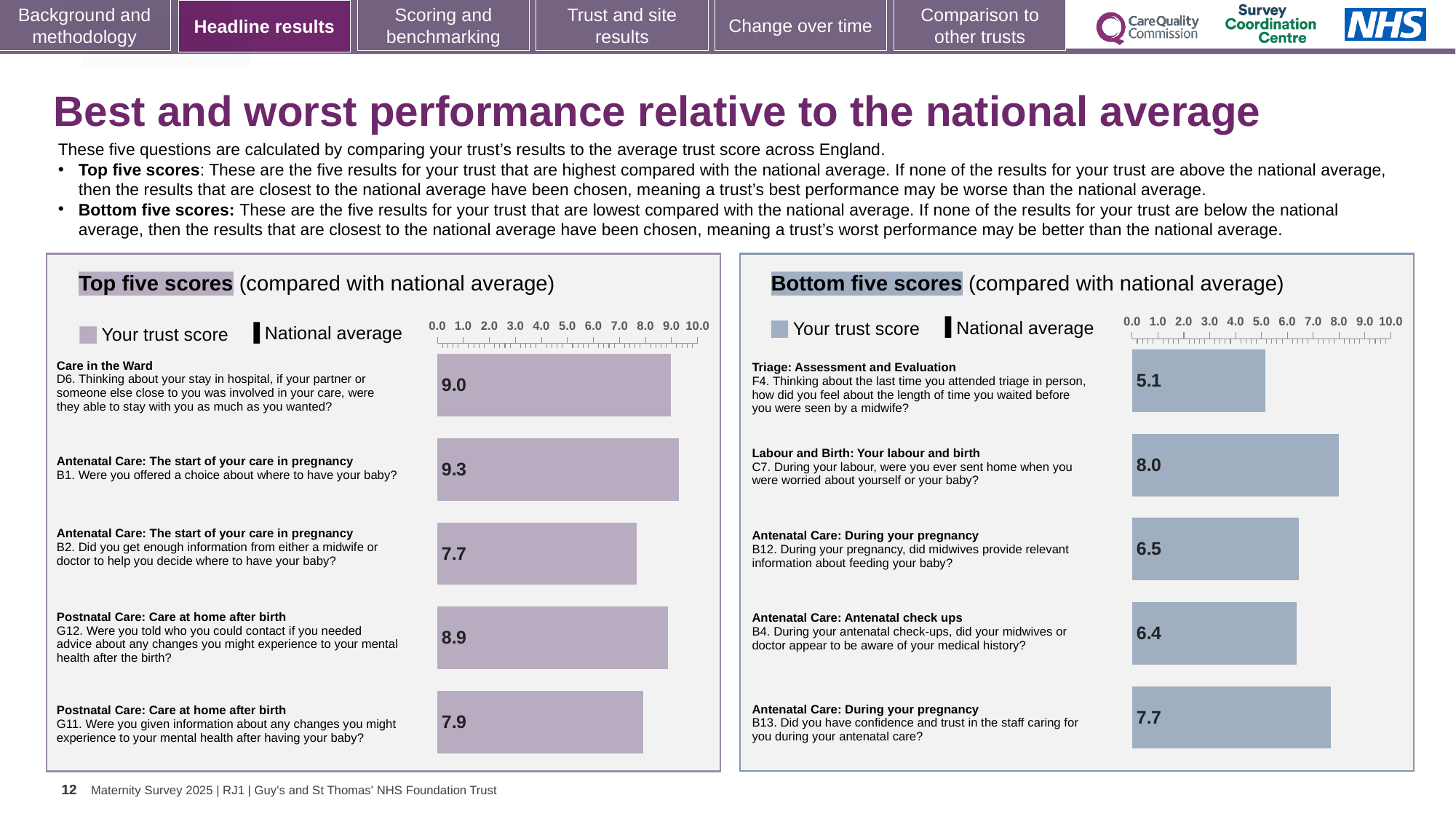
In the Bottom five scores chart, what is the difference between the trust scores for C7 and F4? 2.9 In the Bottom five scores chart, which question has the lowest trust score? F4 (Triage: Assessment and Evaluation) In the Bottom five scores chart, which question has the highest trust score? C7 (Labour and Birth: Your labour and birth) What type of chart is the Bottom five scores chart? Bar chart In the Top five scores chart, what is the trust score for G12 (Postnatal Care: Care at home after birth)? 8.9 In the Top five scores chart, which question has the highest trust score? B1 (Antenatal Care: The start of your care in pregnancy) In the Top five scores chart, is the trust score for D6 (Care in the Ward) greater or less than 8.0? greater In the Top five scores chart, what is the difference between the trust scores for B1 and B2? 1.6 In the Bottom five scores chart, which has the larger trust score, C7 or B13? C7 In the Bottom five scores chart, what is the trust score for F4 (Triage: Assessment and Evaluation)? 5.1 In the Top five scores chart, what is the trust score for B1 (Were you offered a choice about where to have your baby?)? 9.3 How many bars are shown in the Top five scores chart? 5